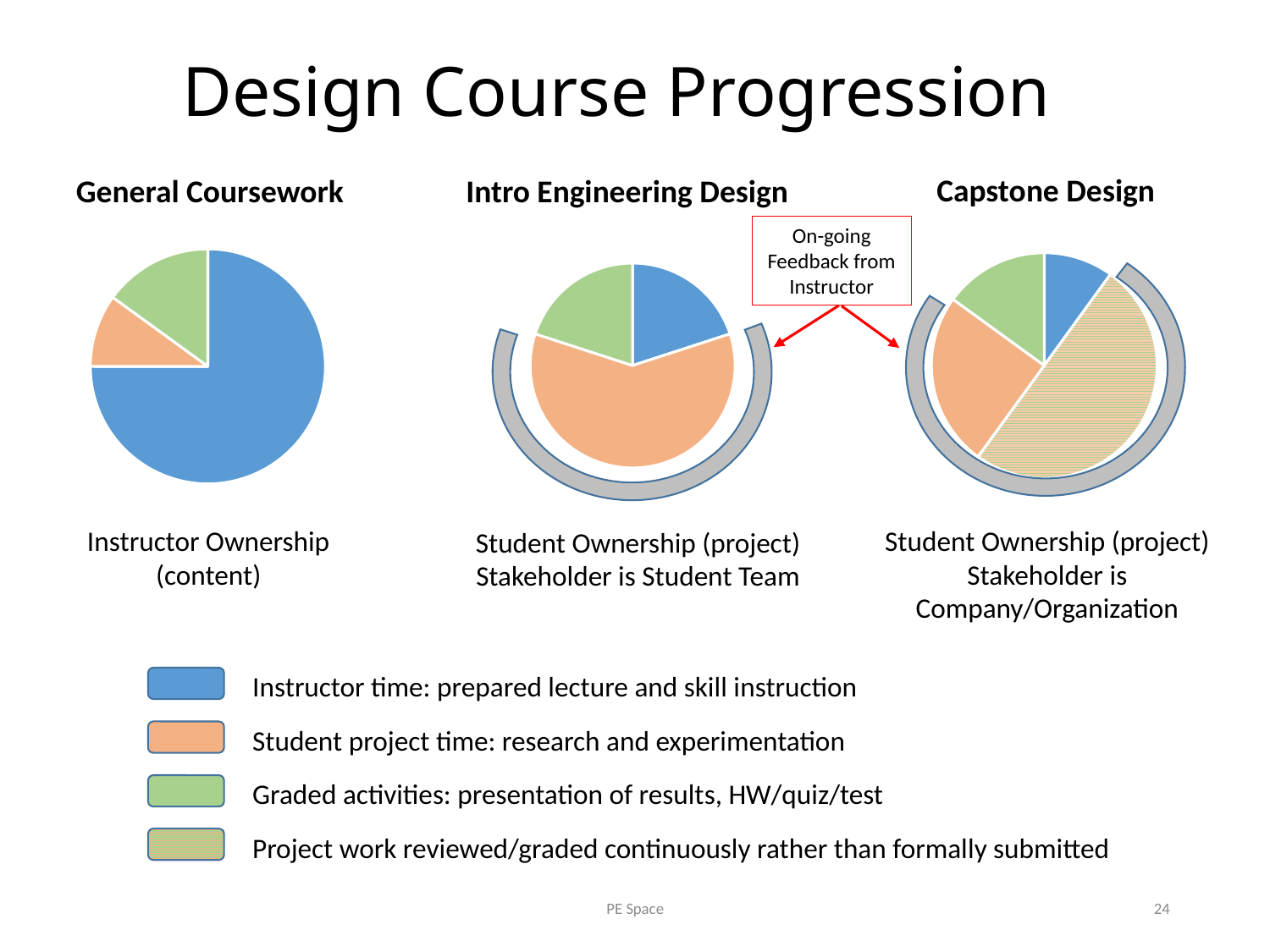
What kind of chart is used under the heading "General Coursework"? Pie chart In the "Intro Engineering Design" pie chart, which category takes the largest share? Student project time: research and experimentation In the "Capstone Design" pie chart, is the share for student project time larger or smaller than the share for instructor time? Larger In the "Capstone Design" pie chart, which category takes the largest share? Project work reviewed/graded continuously rather than formally submitted In the "General Coursework" pie chart, is the share for instructor time larger or smaller than the share for graded activities? Larger In the "Capstone Design" pie chart, which category takes the smallest share? Instructor time: prepared lecture and skill instruction In the "General Coursework" pie chart, which category takes the largest share? Instructor time: prepared lecture and skill instruction Which colour represents "Graded activities: presentation of results, HW/quiz/test" in the pie charts? Green In the "General Coursework" pie chart, which category takes the smallest share? Student project time: research and experimentation How many entries does the legend at the bottom of the slide list? 4 How many slices does the "Capstone Design" pie chart have? 4 How many slices does the "General Coursework" pie chart have? 3